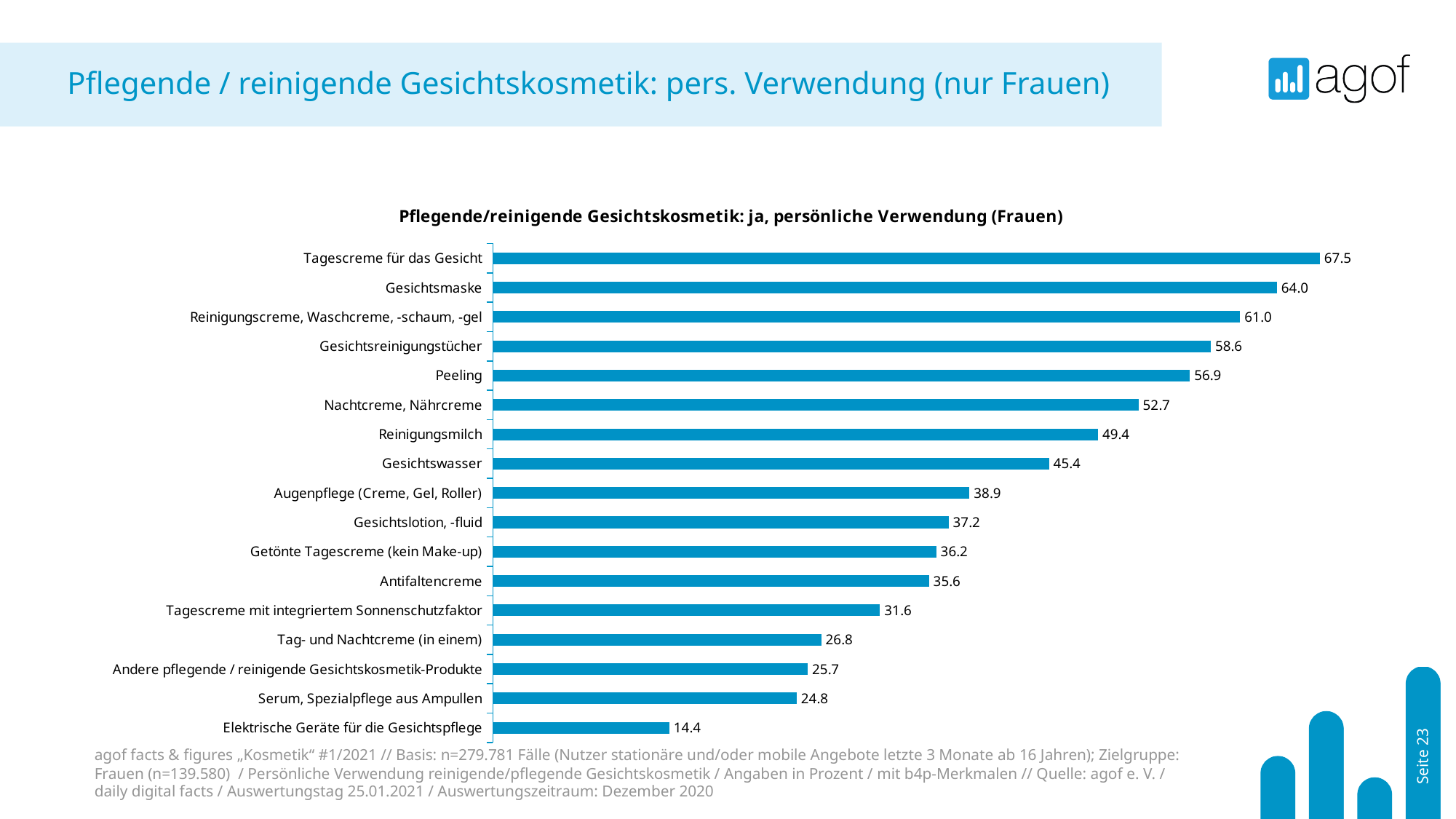
What is the difference between the values for Tagescreme für das Gesicht and Gesichtsmaske? 3.5 Which is larger, the value for Nachtcreme, Nährcreme or the value for Augenpflege (Creme, Gel, Roller)? Nachtcreme, Nährcreme How many categories are shown in the chart? 17 What is the value for Serum, Spezialpflege aus Ampullen? 24.8 Which category has the lowest value? Elektrische Geräte für die Gesichtspflege What is the title of the chart? Pflegende/reinigende Gesichtskosmetik: ja, persönliche Verwendung (Frauen) What is the value for Peeling? 56.9 What is the difference between the values for Reinigungsmilch and Gesichtswasser? 4.0 Which category has the highest value? Tagescreme für das Gesicht What kind of chart is shown on the slide? Bar chart What is the value for Tag- und Nachtcreme (in einem)? 26.8 What is the value for Gesichtsmaske? 64.0